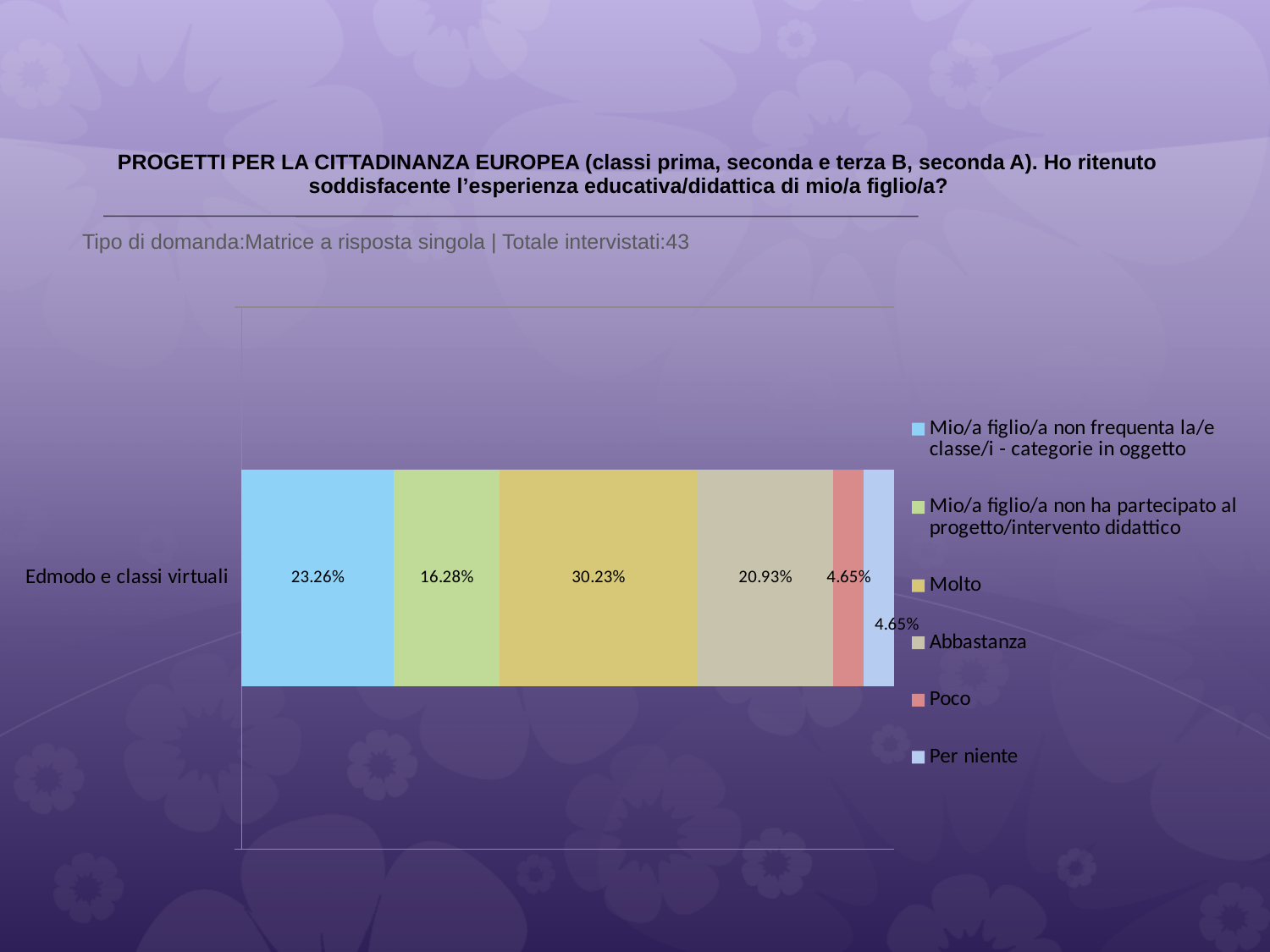
How many series does the legend list? 6 What is the value for "Molto" for Edmodo e classi virtuali? 30.23% What is the label of the single category on the axis? Edmodo e classi virtuali Which is larger, the value for "Mio/a figlio/a non frequenta la/e classe/i - categorie in oggetto" or the value for "Mio/a figlio/a non ha partecipato al progetto/intervento didattico"? Mio/a figlio/a non frequenta la/e classe/i - categorie in oggetto Which series has the highest value in the bar for Edmodo e classi virtuali? Molto How many categories are plotted on the axis? 1 What is the value for "Poco" for Edmodo e classi virtuali? 4.65% What is the total of the stacked bar for Edmodo e classi virtuali? 100.00% What is the value for "Mio/a figlio/a non ha partecipato al progetto/intervento didattico"? 16.28% What kind of chart is shown on the slide? Stacked bar chart What is the value for "Abbastanza" for Edmodo e classi virtuali? 20.93% What is the difference between the values for "Molto" and "Abbastanza"? 9.30%